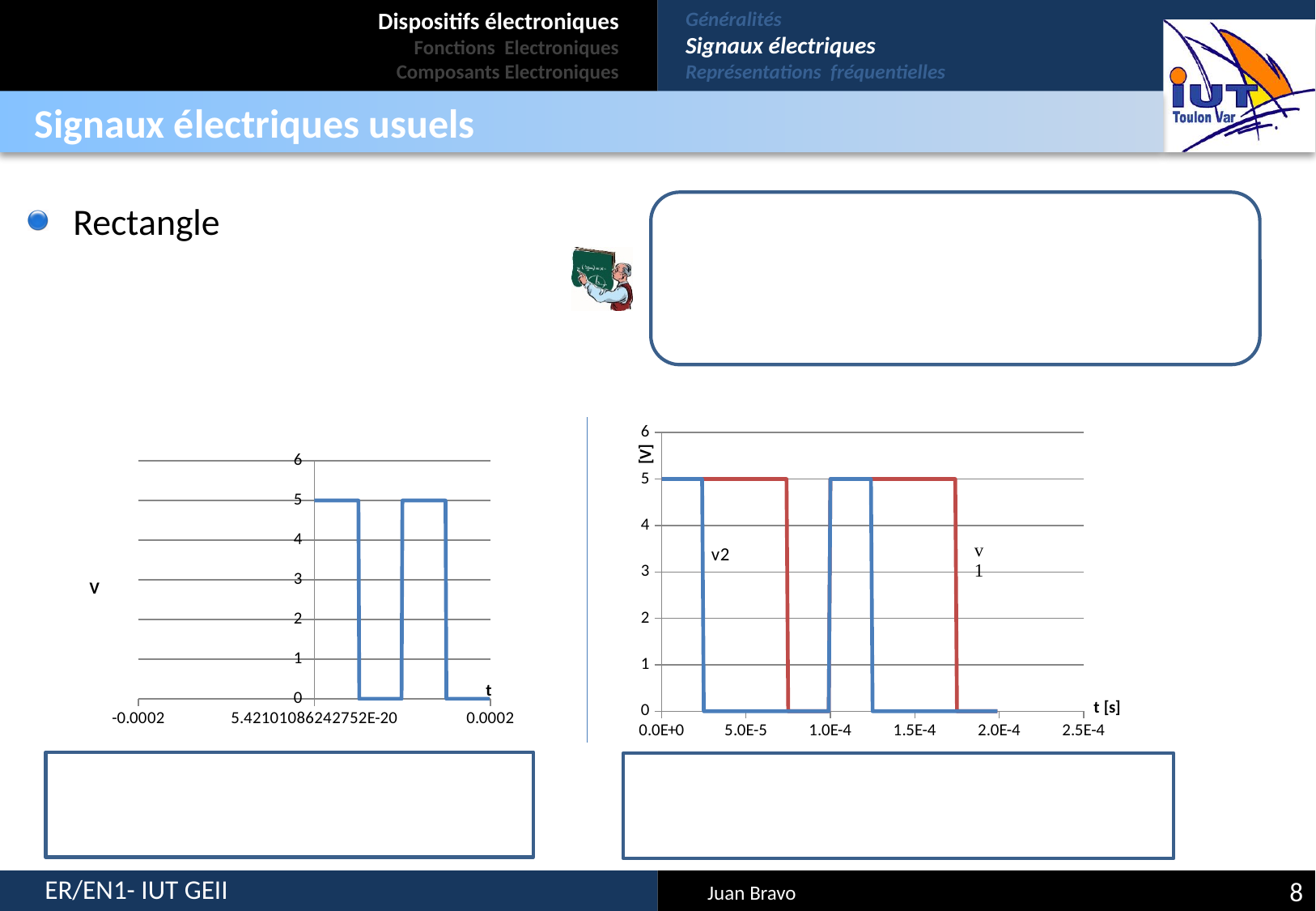
On the right chart, which series is drawn in red? v1 On the right chart, how many signal series are plotted? 2 On the right chart, what is the high level of the v1 signal? 5 On the left chart, what is the highest value the signal reaches? 5 On the right chart, is the high level of v2 greater or less than 4? greater On the right chart, at t = 5.0E-5, which series has the larger value, v1 or v2? v1 On the left chart, what is the label of the vertical axis? v On the left chart, what is the lowest value the signal reaches? 0 On the right chart, what is the value of v1 at t = 2.0E-4? 0 What kind of chart is the left chart on the slide? line chart On the right chart, what is the largest tick value shown on the horizontal axis? 2.5E-4 On the right chart, what is the value of v2 at t = 0.0E+0? 5